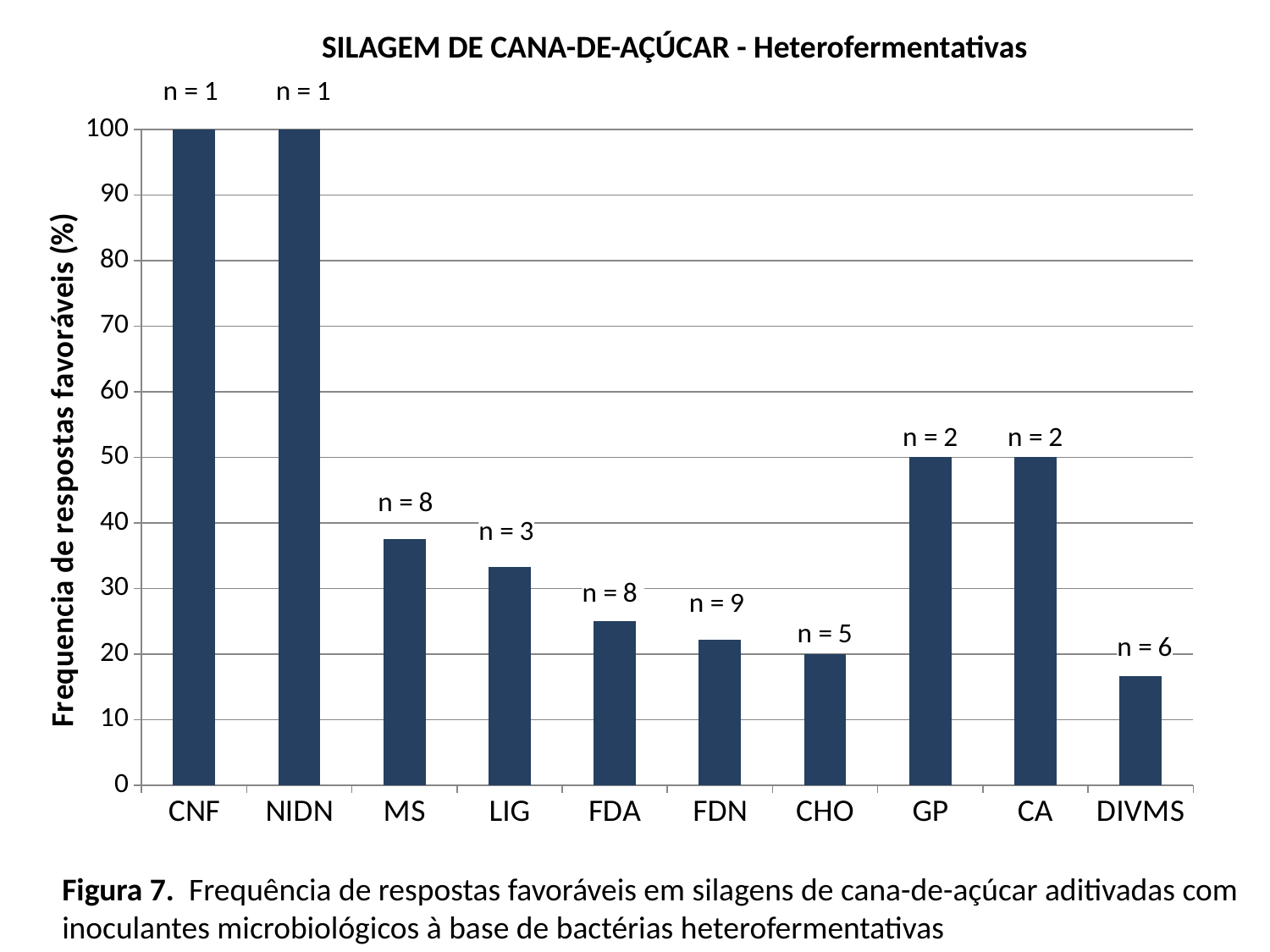
Which category has the lowest frequency of favourable responses? DIVMS What is the frequency of favourable responses (%) for CHO? 20 What is the title of the chart? SILAGEM DE CANA-DE-AÇÚCAR - Heterofermentativas What is the difference between the values for CNF and CA? 50 What is the n value printed above the FDN bar? n = 9 Which has a higher frequency of favourable responses, MS or LIG? MS What is the frequency of favourable responses (%) for GP? 50 Is the value for MS greater or less than 40? less What kind of chart is shown on the slide? bar chart What is the frequency of favourable responses (%) for CNF? 100 How many categories are shown on the x axis of the chart? 10 Is the value for LIG greater or less than 30? greater